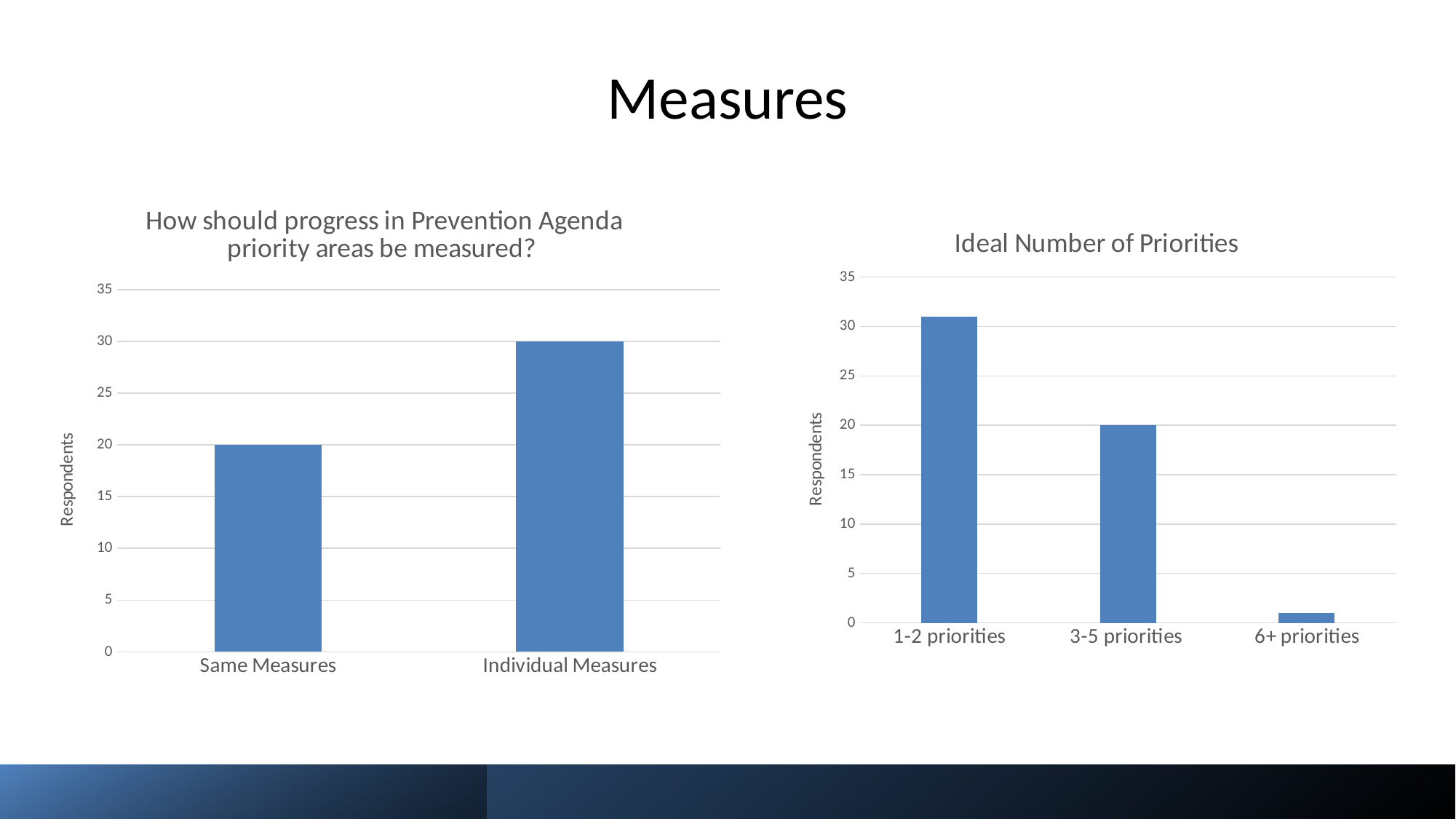
In the 'Ideal Number of Priorities' chart, which category has the fewest respondents? 6+ priorities In the 'Ideal Number of Priorities' chart, how many respondents chose 3-5 priorities? 20 In the chart 'How should progress in Prevention Agenda priority areas be measured?', how many respondents chose Individual Measures? 30 In the 'Ideal Number of Priorities' chart, which category has the most respondents? 1-2 priorities In the 'Ideal Number of Priorities' chart, is the value for 1-2 priorities greater or less than 30? greater In the chart 'How should progress in Prevention Agenda priority areas be measured?', what is the difference in respondents between Individual Measures and Same Measures? 10 In the chart 'How should progress in Prevention Agenda priority areas be measured?', which option has the higher number of respondents? Individual Measures What type of chart is the 'Ideal Number of Priorities' chart? bar chart In the chart 'How should progress in Prevention Agenda priority areas be measured?', how many respondents chose Same Measures? 20 In the chart 'How should progress in Prevention Agenda priority areas be measured?', how many categories are shown on the x axis? 2 In the 'Ideal Number of Priorities' chart, is the value for 6+ priorities greater or less than 5? less In the 'Ideal Number of Priorities' chart, do the values rise or fall moving from left to right along the x axis? fall